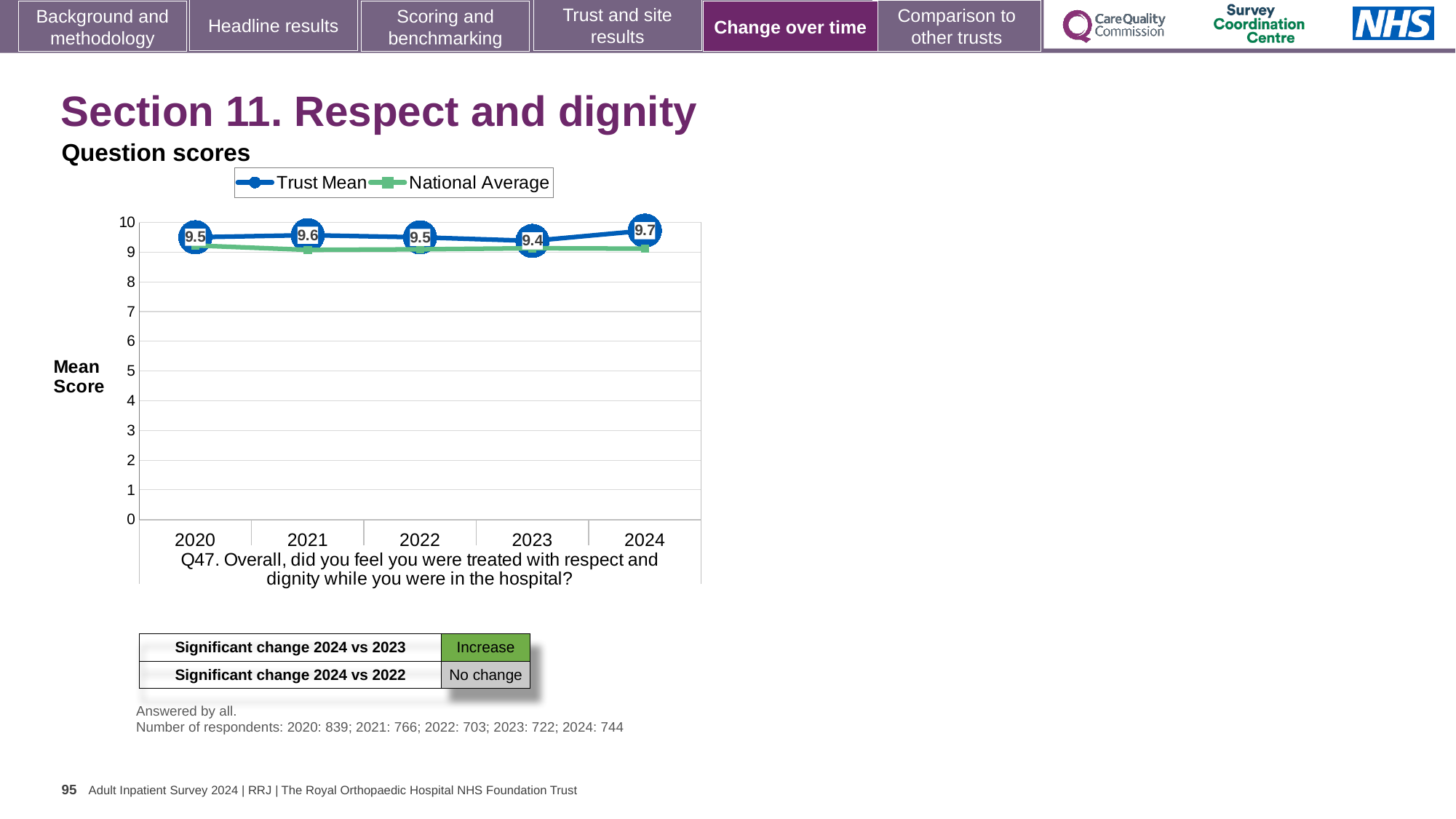
Is the National Average value for 2024 greater or less than 8? greater What is the Trust Mean score for 2023? 9.4 In which year is the Trust Mean score lowest? 2023 What is the label of the y axis of the chart? Mean Score What is the Trust Mean score for 2024? 9.7 What is the Trust Mean score for 2021? 9.6 What kind of chart is shown on the slide? Line chart Which is larger, the Trust Mean score in 2021 or in 2023? 2021 How many years are shown on the x axis of the chart? 5 In which year is the Trust Mean score highest? 2024 How many series does the chart legend list? 2 What is the difference between the Trust Mean score in 2024 and in 2023? 0.3